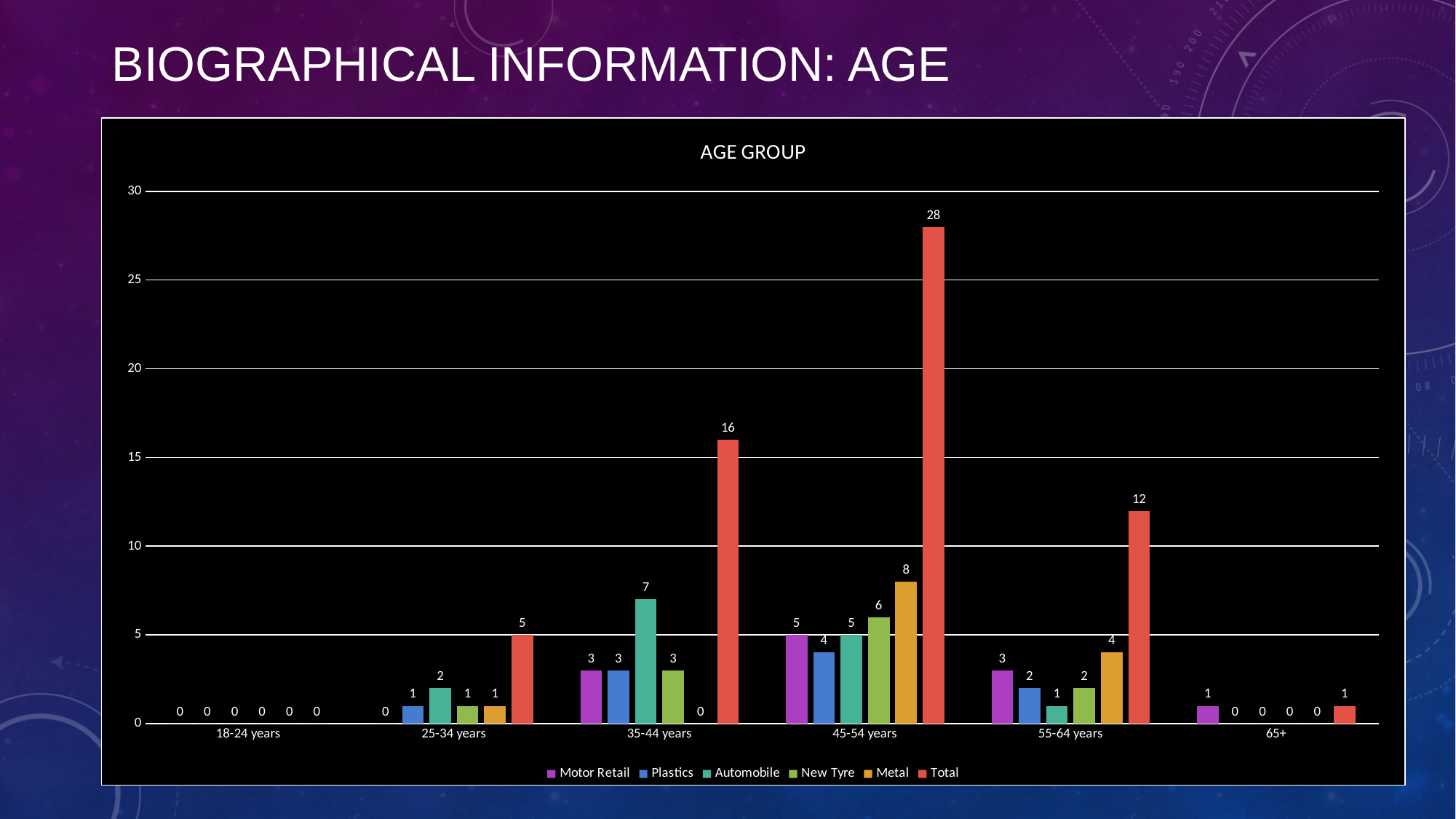
What is the Total value for the 45-54 years age group? 28 What is the Metal value for the 45-54 years age group? 8 What is the Automobile value for the 35-44 years age group? 7 What kind of chart is shown on the slide? Bar chart Which age group has the highest Total value? 45-54 years Which age group has the lowest Total value? 18-24 years What is the title of the chart? AGE GROUP How many age group categories are shown on the x axis? 6 Which is larger, the Metal value for 55-64 years or the Metal value for 25-34 years? 55-64 years What is the difference between the Total values for 45-54 years and 35-44 years? 12 How many series does the legend list? 6 Is the Total value for 55-64 years greater or less than 10? greater